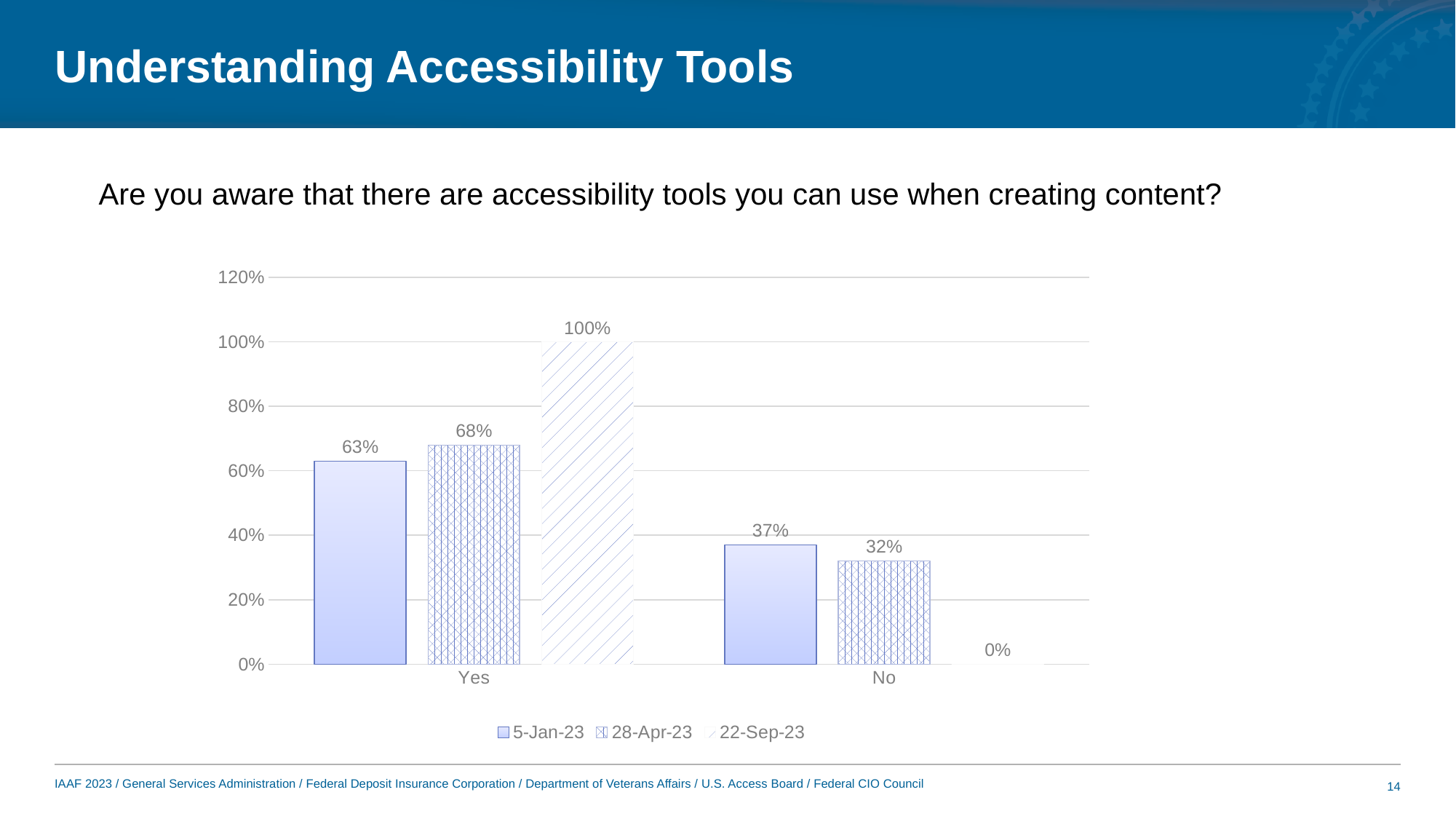
Which series has the lowest value for "No"? 22-Sep-23 What kind of chart is shown on the slide? Bar chart What is the value for "Yes" in the 5-Jan-23 series? 63% What is the value for "No" in the 5-Jan-23 series? 37% How many series does the legend list? 3 What is the value for "Yes" in the 22-Sep-23 series? 100% Which series has the highest value for "Yes"? 22-Sep-23 What is the difference between the 28-Apr-23 and 5-Jan-23 values for "Yes"? 5% What is the value for "Yes" in the 28-Apr-23 series? 68% What is the value for "No" in the 22-Sep-23 series? 0% How many categories are shown on the x axis? 2 Which is larger: the 5-Jan-23 value for "No" or the 28-Apr-23 value for "No"? 5-Jan-23